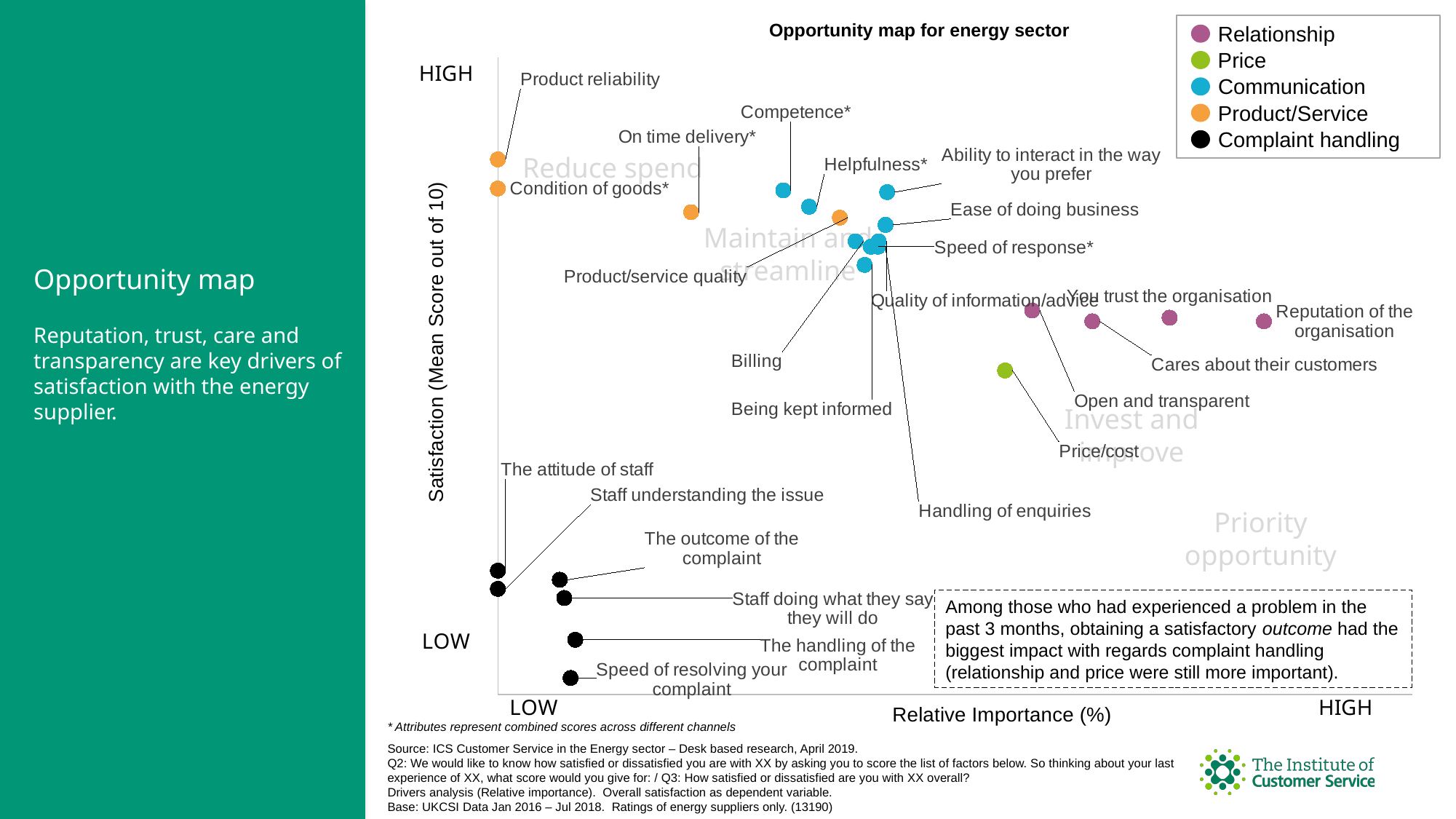
What is the label of the vertical axis of the chart? Satisfaction (Mean Score out of 10) Which has the higher satisfaction score, Product reliability or Price/cost? Product reliability What is the title of the chart? Opportunity map for energy sector Which attribute has the lowest satisfaction score on the chart? Speed of resolving your complaint Which attribute has the highest satisfaction score on the chart? Product reliability Which has the higher satisfaction score, The attitude of staff or Competence*? Competence* How many points belong to the Complaint handling series? 6 How many points belong to the Price series? 1 Which has the higher relative importance, Reputation of the organisation or Product reliability? Reputation of the organisation How many series does the chart legend list? 5 Which attribute has the highest relative importance on the chart? Reputation of the organisation What kind of chart is shown on the slide? Scatter chart